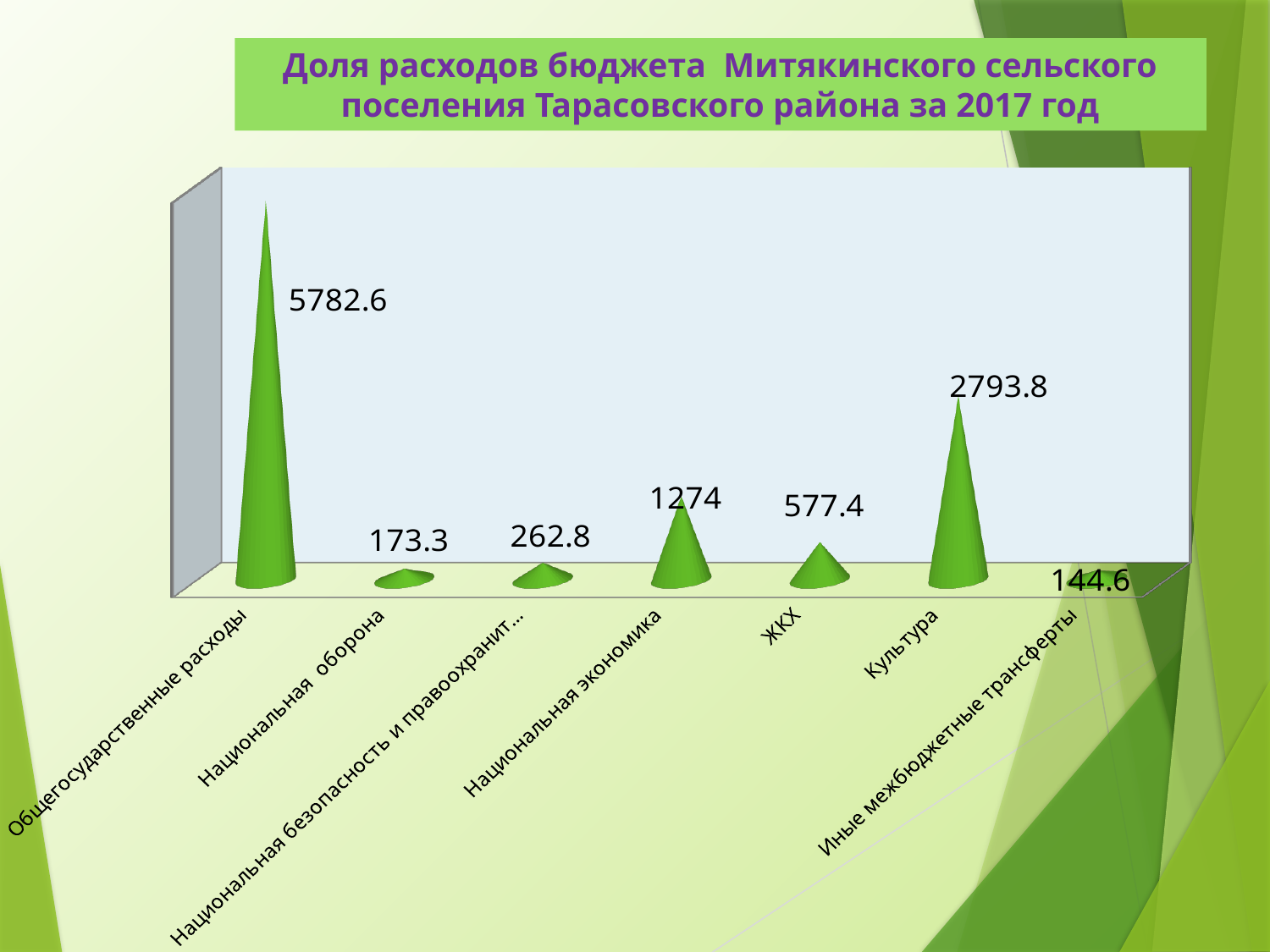
What is the value for Культура? 2793.8 How many categories are shown in the chart? 7 Which category has the lowest value? Иные межбюджетные трансферты What is the difference between the values for Общегосударственные расходы and Культура? 2988.8 What is the value for ЖКХ? 577.4 What is the value for Иные межбюджетные трансферты? 144.6 Which category has the highest value? Общегосударственные расходы What is the value for Общегосударственные расходы? 5782.6 What is the difference between the values for Национальная экономика and ЖКХ? 696.6 What is the value for Национальная экономика? 1274 What kind of chart is shown on the slide? Bar chart Which is larger, the value for Национальная оборона or the value for Иные межбюджетные трансферты? Национальная оборона